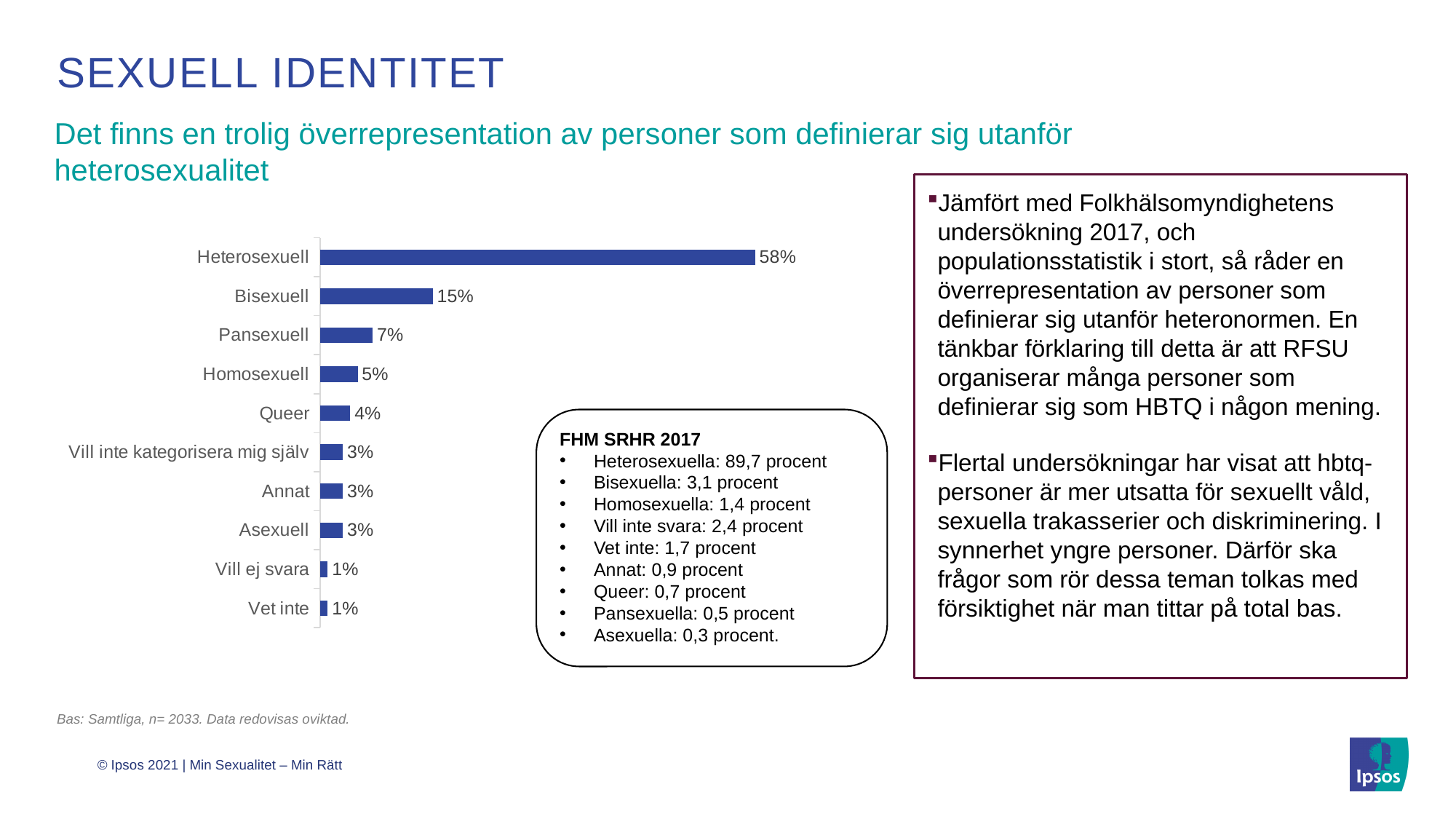
What is the value for Queer? 4% What is the value for Heterosexuell? 58% Which category has the highest value? Heterosexuell What is the value for Bisexuell? 15% How many categories are shown in the chart? 10 Which is larger, the value for Homosexuell or the value for Queer? Homosexuell What is the value for Pansexuell? 7% What is the difference between the values for Pansexuell and Homosexuell? 2% What is the value for Asexuell? 3% What is the difference between the values for Heterosexuell and Bisexuell? 43% What is the value for Vet inte? 1% What kind of chart is shown on the slide? Bar chart